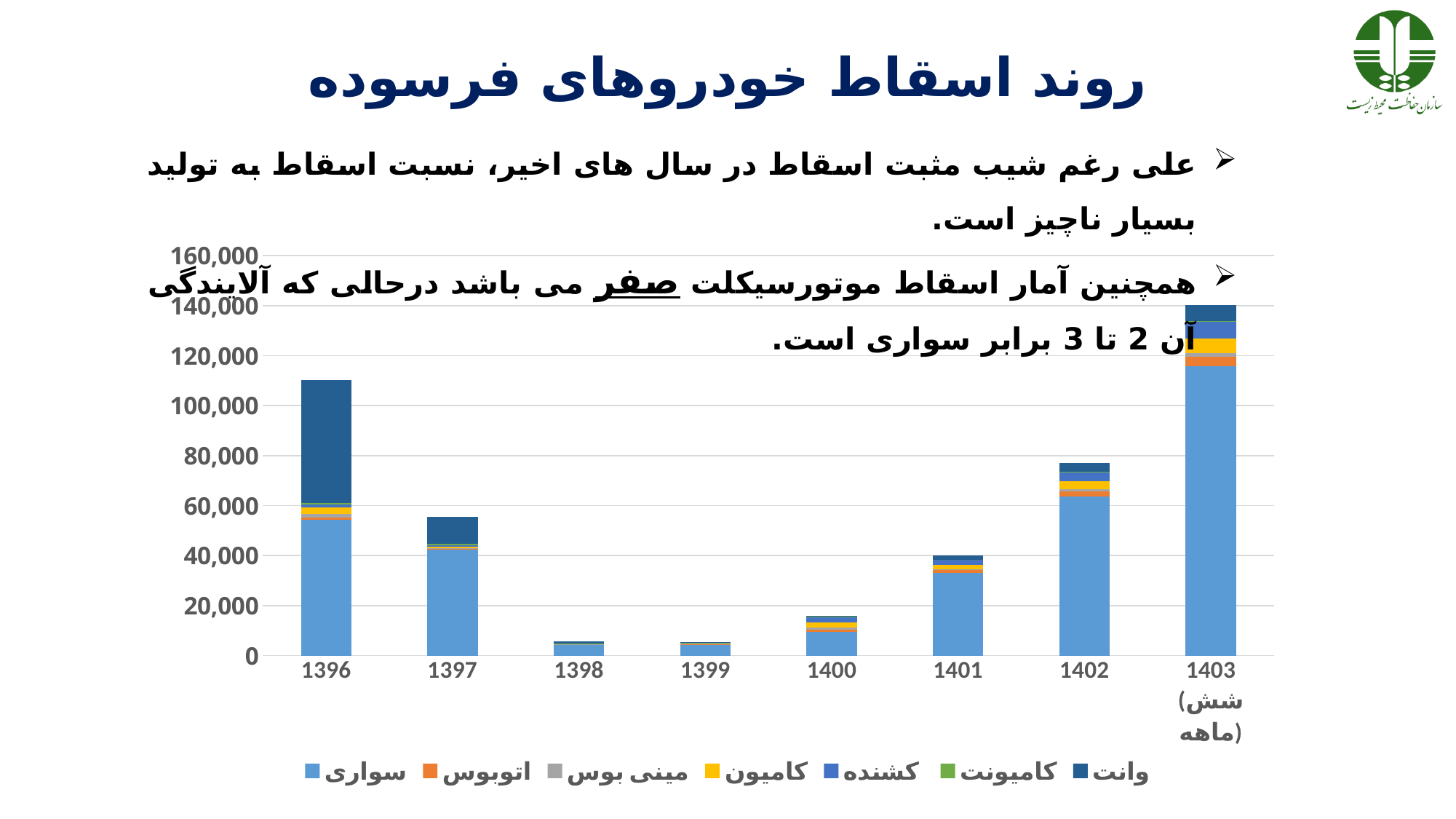
How many year categories are shown on the x axis of the chart? 8 Is the total value for 1402 greater or less than 80,000? less Is the total value for 1403 greater or less than 120,000? greater Do the total bar values rise or fall from 1399 through 1403? rise Is the total value for 1397 greater or less than 60,000? less Which year has the highest total stacked bar in the chart? 1403 What kind of chart is shown on the slide? stacked bar chart What is the title of the slide containing the chart? روند اسقاط خودروهای فرسوده How many series does the chart legend list? 7 Which has the larger total bar, 1396 or 1397? 1396